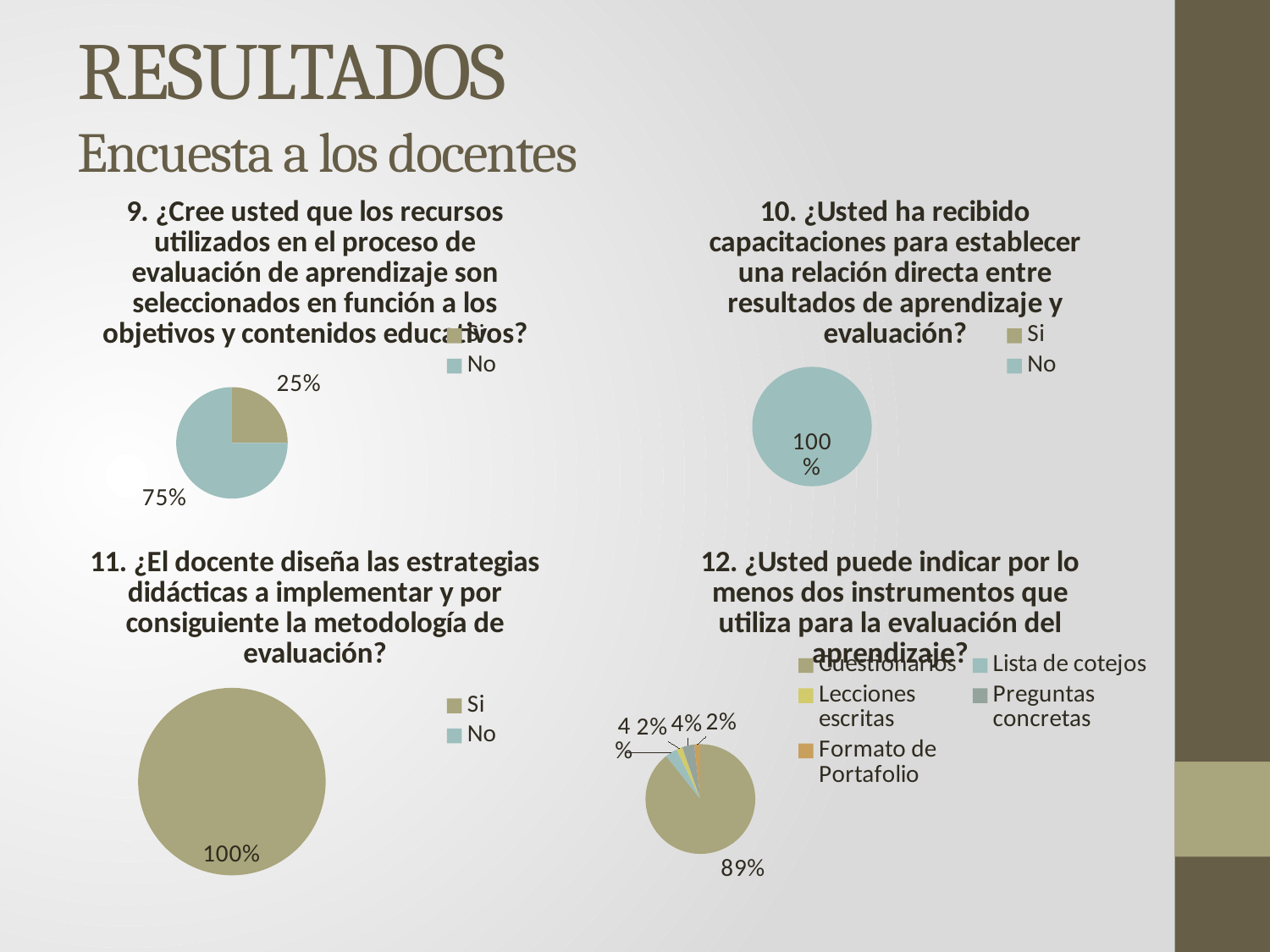
In the chart for question 11 (bottom-left), which answer accounts for 100% of responses? Si How many pie charts are shown on the slide? 4 In the chart for question 9 (top-left), what share of respondents answered No? 75% In the chart for question 12 (bottom-right), which instrument has the largest share? Cuestionarios In the chart for question 10 (top-right), what percentage is printed on the single slice? 100% In the chart for question 9 (top-left), what share of respondents answered Si? 25% In the chart for question 10 (top-right), which answer accounts for 100% of responses? No How many entries does the legend of the chart for question 12 (bottom-right) list? 5 What kind of chart is used for question 9 (top-left)? Pie chart In the chart for question 12 (bottom-right), what share is shown for Cuestionarios? 89% In the chart for question 9 (top-left), which answer has the larger share, Si or No? No In the chart for question 9 (top-left), what is the difference between the No share and the Si share? 50%